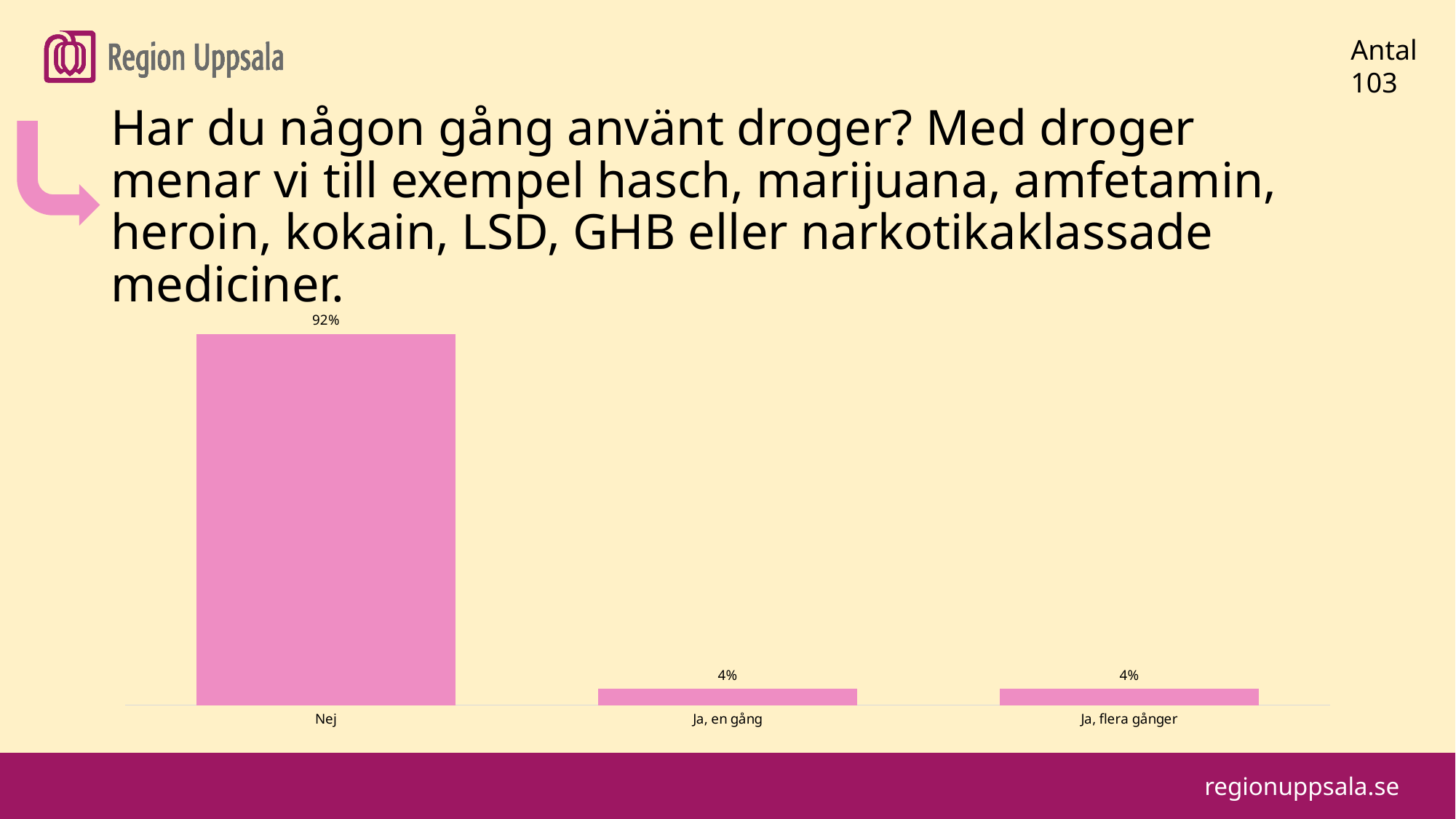
What is the value for "Ja, en gång"? 4% What is the value for "Ja, flera gånger"? 4% What number is shown next to "Antal" in the top right corner of the slide? 103 How many categories are shown in the chart? 3 What kind of chart is shown on the slide? Bar chart What is the total of the values for "Ja, en gång" and "Ja, flera gånger"? 8% What is the difference between the values for "Nej" and "Ja, en gång"? 88% Which is larger, the value for "Nej" or the value for "Ja, flera gånger"? Nej Which category has the highest value? Nej What is the value for "Nej"? 92% What colour are the bars in the chart? Pink